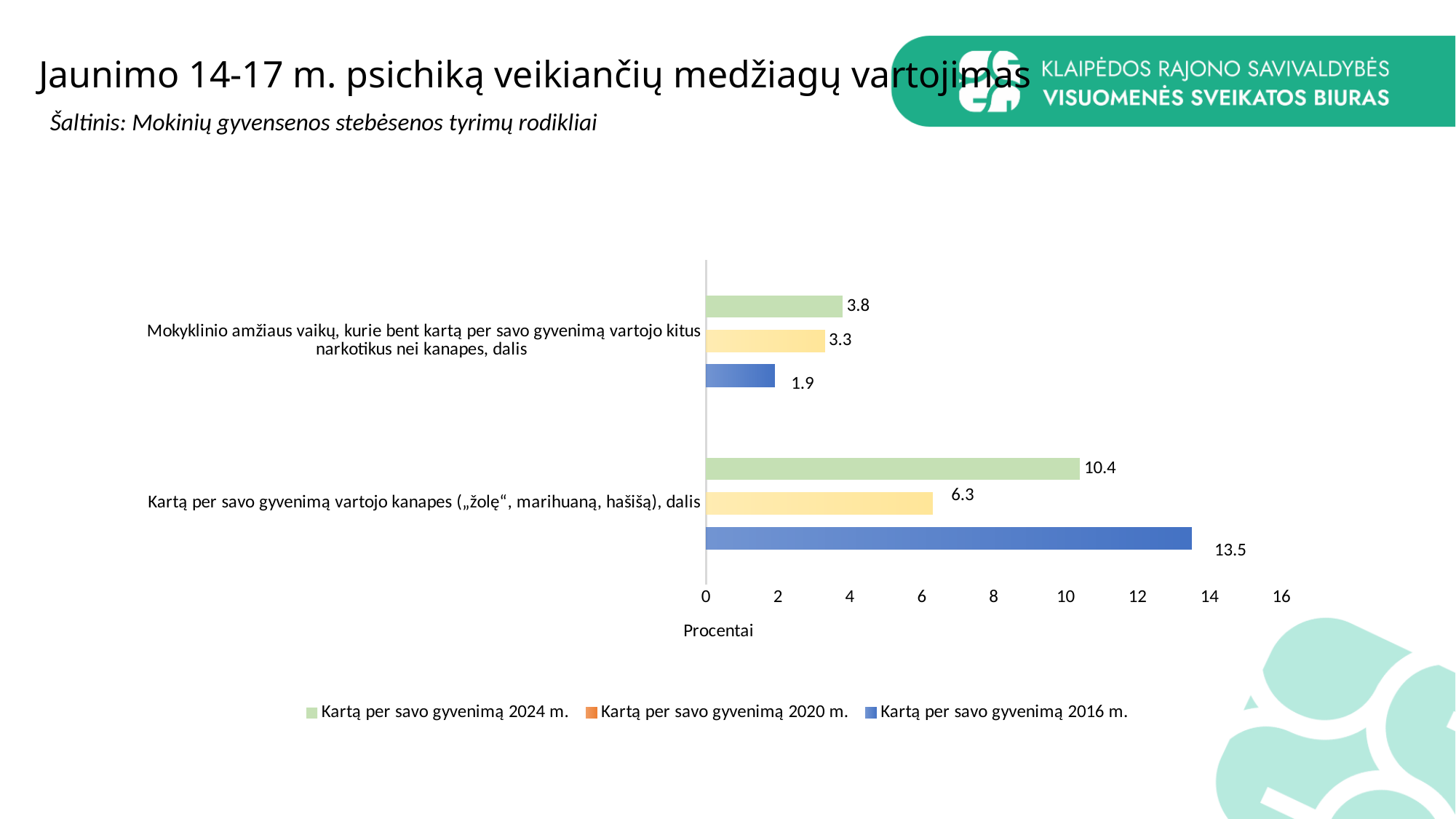
Which series has the highest value in the category 'Kartą per savo gyvenimą vartojo kanapes („žolę“, marihuaną, hašišą), dalis'? Kartą per savo gyvenimą 2016 m. What is the difference between the 2016 and 2024 values in the category 'Kartą per savo gyvenimą vartojo kanapes („žolę“, marihuaną, hašišą), dalis'? 3.1 Is the 2020 value for 'Kartą per savo gyvenimą vartojo kanapes („žolę“, marihuaną, hašišą), dalis' greater or less than 8? less How many series does the legend list? 3 Which is larger in the category 'Mokyklinio amžiaus vaikų, kurie bent kartą per savo gyvenimą vartojo kitus narkotikus nei kanapes, dalis': the 2024 value or the 2020 value? 2024 value (3.8) Which series has the lowest value in the category 'Mokyklinio amžiaus vaikų, kurie bent kartą per savo gyvenimą vartojo kitus narkotikus nei kanapes, dalis'? Kartą per savo gyvenimą 2016 m. How many categories are shown on the chart? 2 What is the label of the horizontal axis? Procentai What kind of chart is shown on the slide? bar chart What is the value for 'Kartą per savo gyvenimą 2016 m.' in the category 'Kartą per savo gyvenimą vartojo kanapes („žolę“, marihuaną, hašišą), dalis'? 13.5 What is the value for 'Kartą per savo gyvenimą 2020 m.' in the category 'Mokyklinio amžiaus vaikų, kurie bent kartą per savo gyvenimą vartojo kitus narkotikus nei kanapes, dalis'? 3.3 What is the value for 'Kartą per savo gyvenimą 2024 m.' in the category 'Kartą per savo gyvenimą vartojo kanapes („žolę“, marihuaną, hašišą), dalis'? 10.4